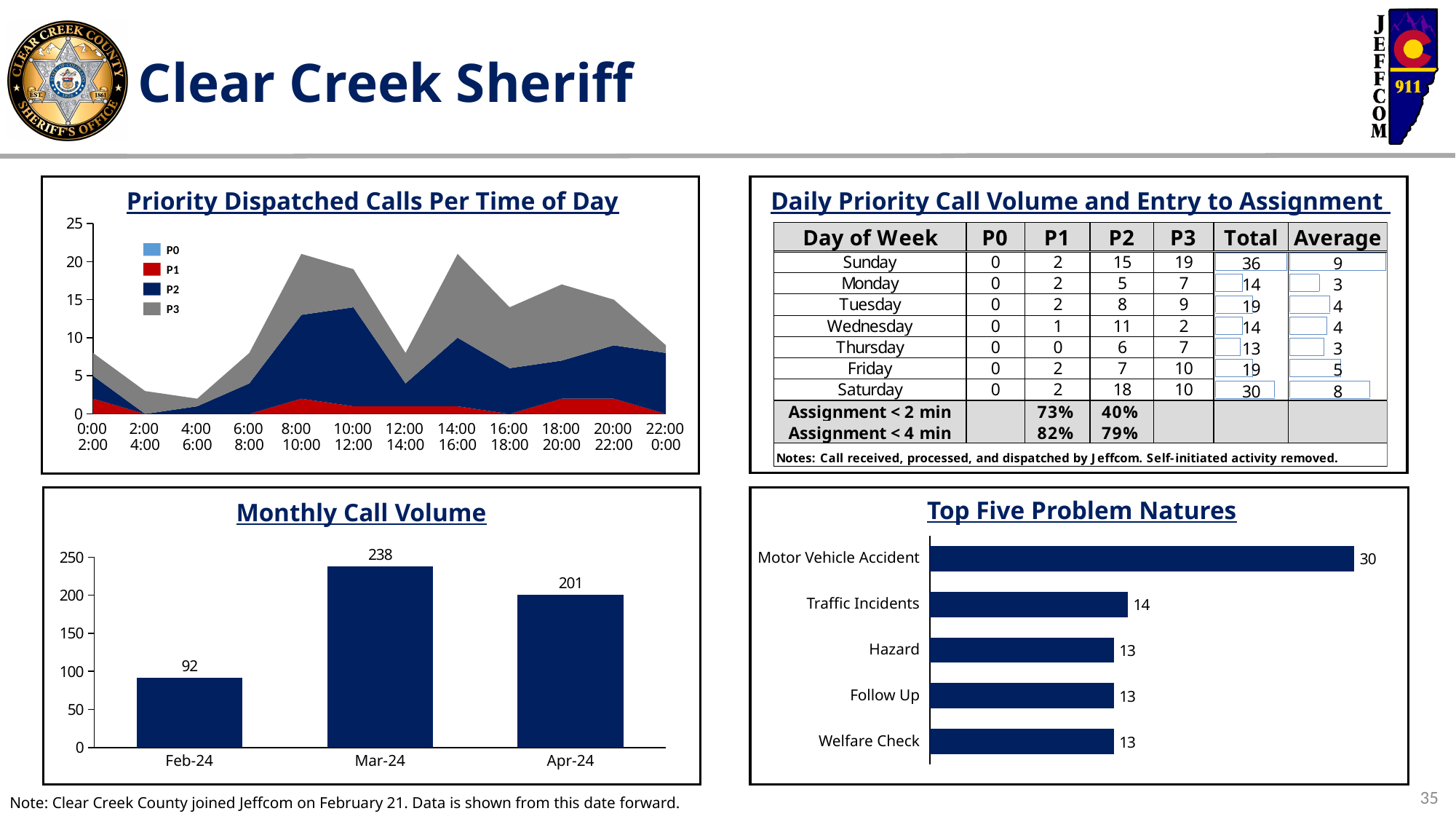
In the Top Five Problem Natures chart, what is the value for Traffic Incidents? 14 In the Monthly Call Volume chart, which month has the highest call volume? Mar-24 In the Monthly Call Volume chart, how many months are shown? 3 In the Monthly Call Volume chart, what is the difference between Mar-24 and Apr-24? 37 In the Top Five Problem Natures chart, what is the difference between Motor Vehicle Accident and Traffic Incidents? 16 In the Priority Dispatched Calls Per Time of Day chart, how many series does the legend list? 4 In the Priority Dispatched Calls Per Time of Day chart, is the total value for the 4:00-6:00 period greater or less than 5? less What kind of chart is the Top Five Problem Natures chart? Bar chart In the Top Five Problem Natures chart, what is the value for Motor Vehicle Accident? 30 In the Monthly Call Volume chart, what is the value for Feb-24? 92 In the Top Five Problem Natures chart, which is larger, Motor Vehicle Accident or Hazard? Motor Vehicle Accident In the Monthly Call Volume chart, what is the value for Mar-24? 238